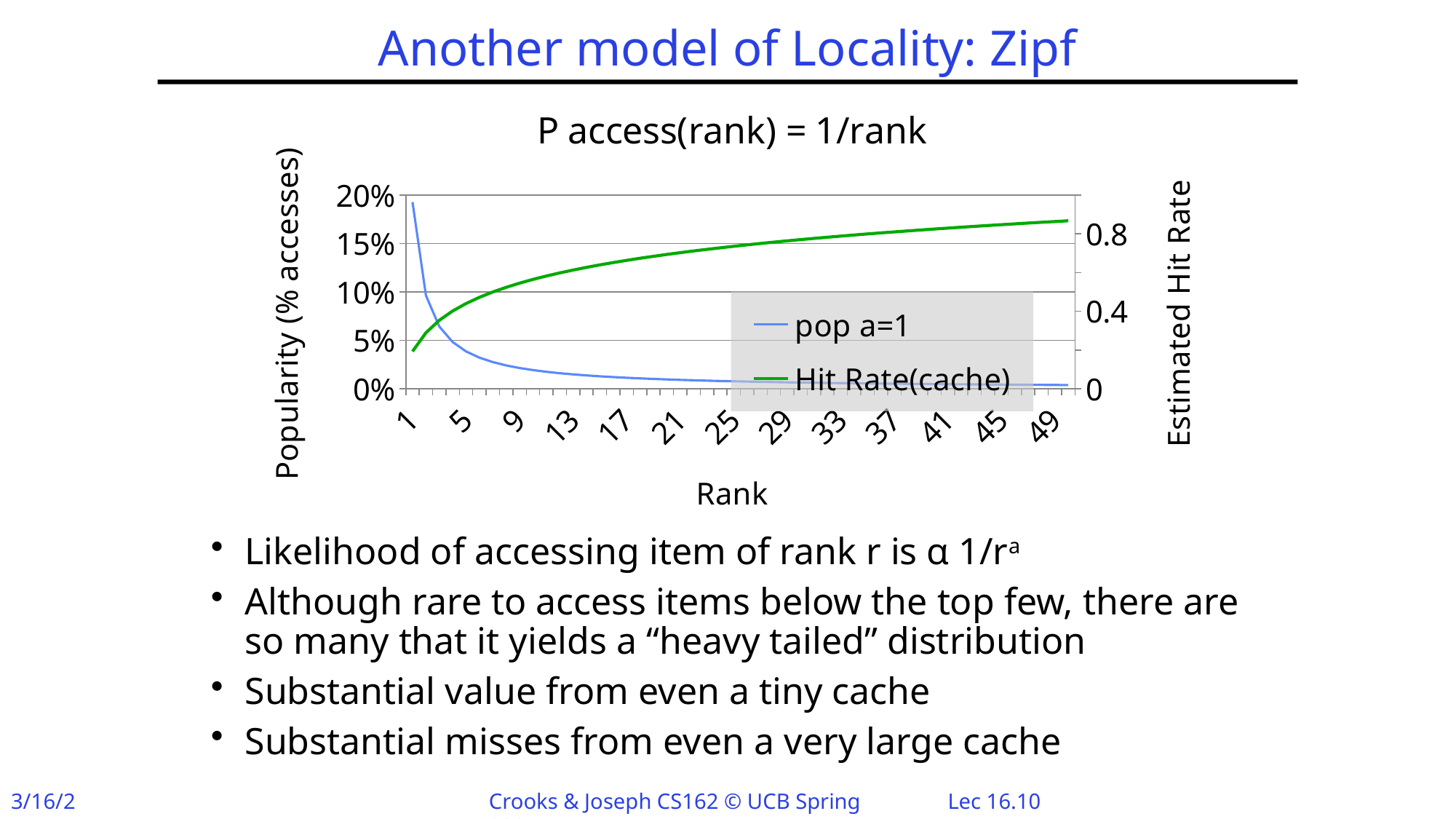
Does the Hit Rate(cache) series rise or fall as rank increases along the x axis? rise What is the title of the chart? P access(rank) = 1/rank Does the pop a=1 series rise or fall as rank increases along the x axis? fall Is the Hit Rate(cache) value at rank 25 greater or less than 0.4? greater What kind of chart is shown on the slide? line chart Is the value of pop a=1 at rank 9 greater or less than 5%? less How many series does the chart's legend list? 2 Is the Hit Rate(cache) value at rank 1 greater or less than 0.4? less What are the two series named in the legend? pop a=1 and Hit Rate(cache) What is the label of the x axis of the chart? Rank